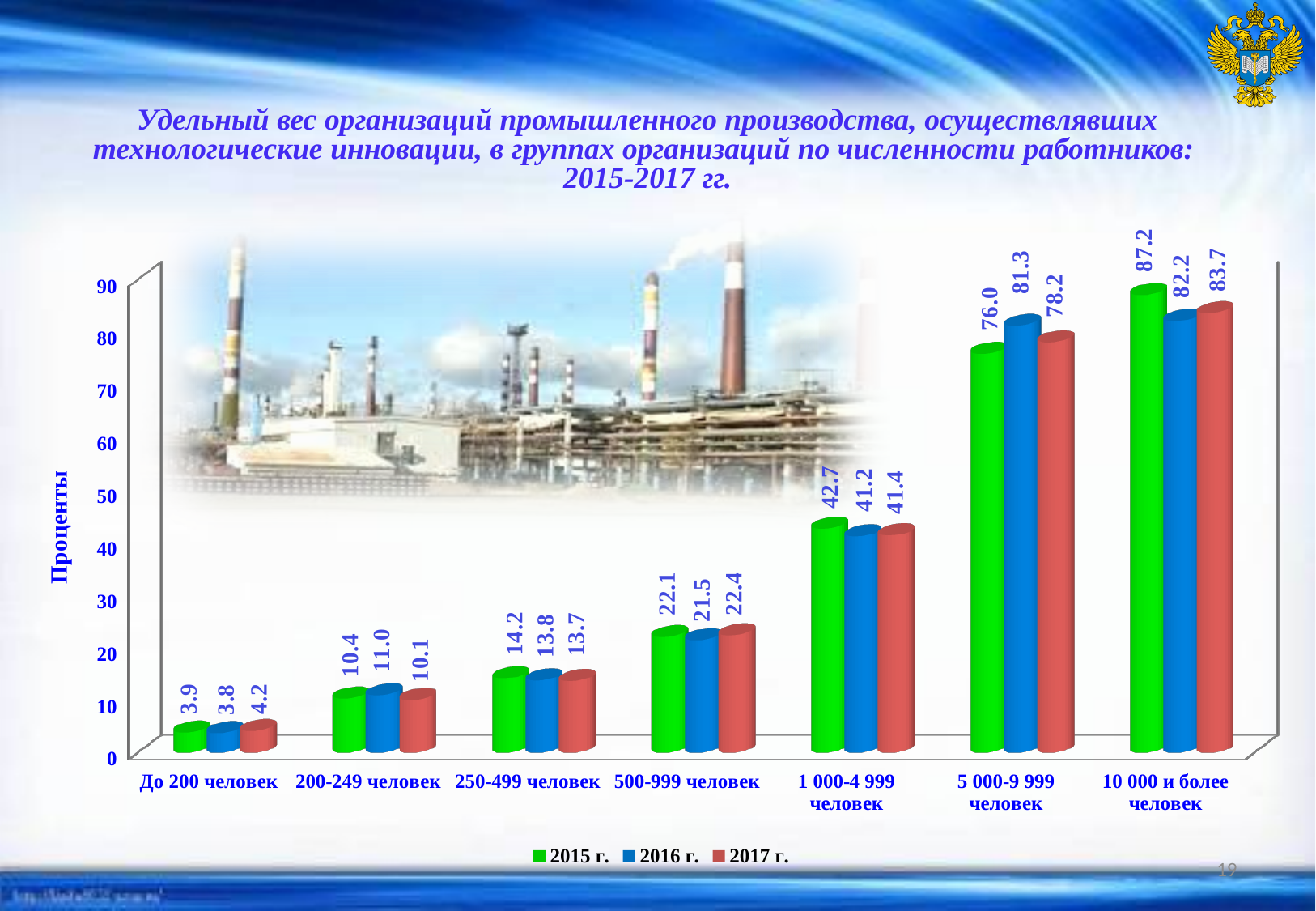
How many employee-size groups are shown on the x axis? 7 What is the value for 2017 г. in the 500-999 человек group? 22.4 What is the value for 2015 г. in the 10 000 и более человек group? 87.2 What is the value for 2016 г. in the 1 000-4 999 человек group? 41.2 Which group has the highest value for 2016 г.? 10 000 и более человек How many series does the legend list? 3 Which is larger in the 250-499 человек group: the 2015 г. value or the 2017 г. value? 2015 г. What kind of chart is shown on the slide? bar chart What is the label of the vertical axis? Проценты Do the 2015 г. values rise or fall as the employee-size groups increase along the x axis? rise What is the difference between the 2016 г. and 2017 г. values in the 5 000-9 999 человек group? 3.1 Which group has the lowest value for 2017 г.? До 200 человек